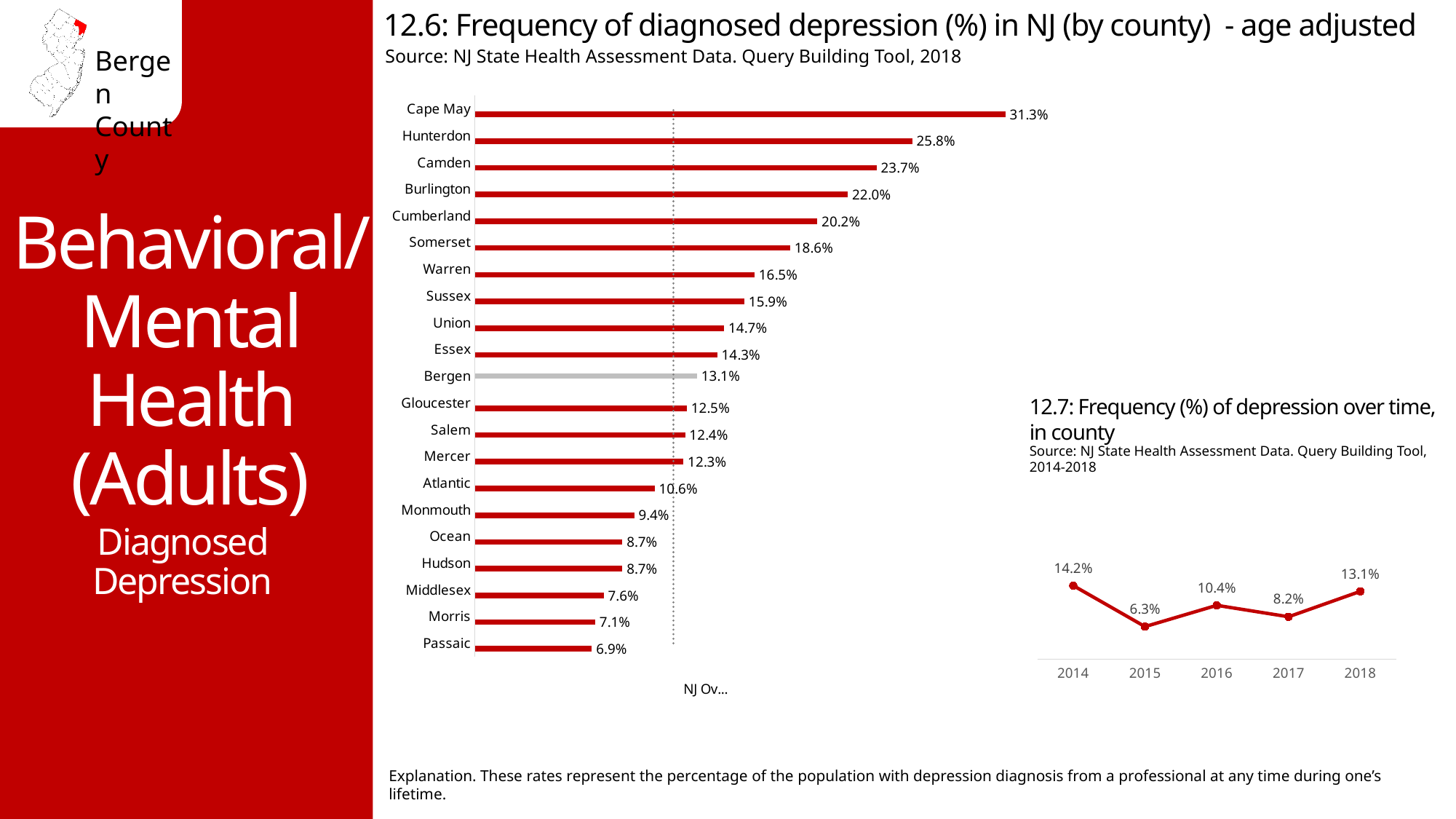
In the chart 12.6 (frequency of diagnosed depression by county), how many counties are plotted? 21 What kind of chart is chart 12.7 (frequency of depression over time, in county)? Line chart In the chart 12.6 (frequency of diagnosed depression by county), which county has the highest value? Cape May In the chart 12.6 (frequency of diagnosed depression by county), what is the difference between Cape May and Hunterdon? 5.5% In the chart 12.7 (frequency of depression over time, in county), what is the value for 2015? 6.3% In the chart 12.7 (frequency of depression over time, in county), what is the difference between 2018 and 2017? 4.9% In the chart 12.6 (frequency of diagnosed depression by county), what is the value for Bergen? 13.1% In the chart 12.6 (frequency of diagnosed depression by county), what is the value for Cumberland? 20.2% In the chart 12.7 (frequency of depression over time, in county), which year has the highest value? 2014 In the chart 12.6 (frequency of diagnosed depression by county), which county has the lowest value? Passaic What kind of chart is chart 12.6 (frequency of diagnosed depression by county)? Bar chart In the chart 12.6 (frequency of diagnosed depression by county), which is larger, Somerset or Warren? Somerset